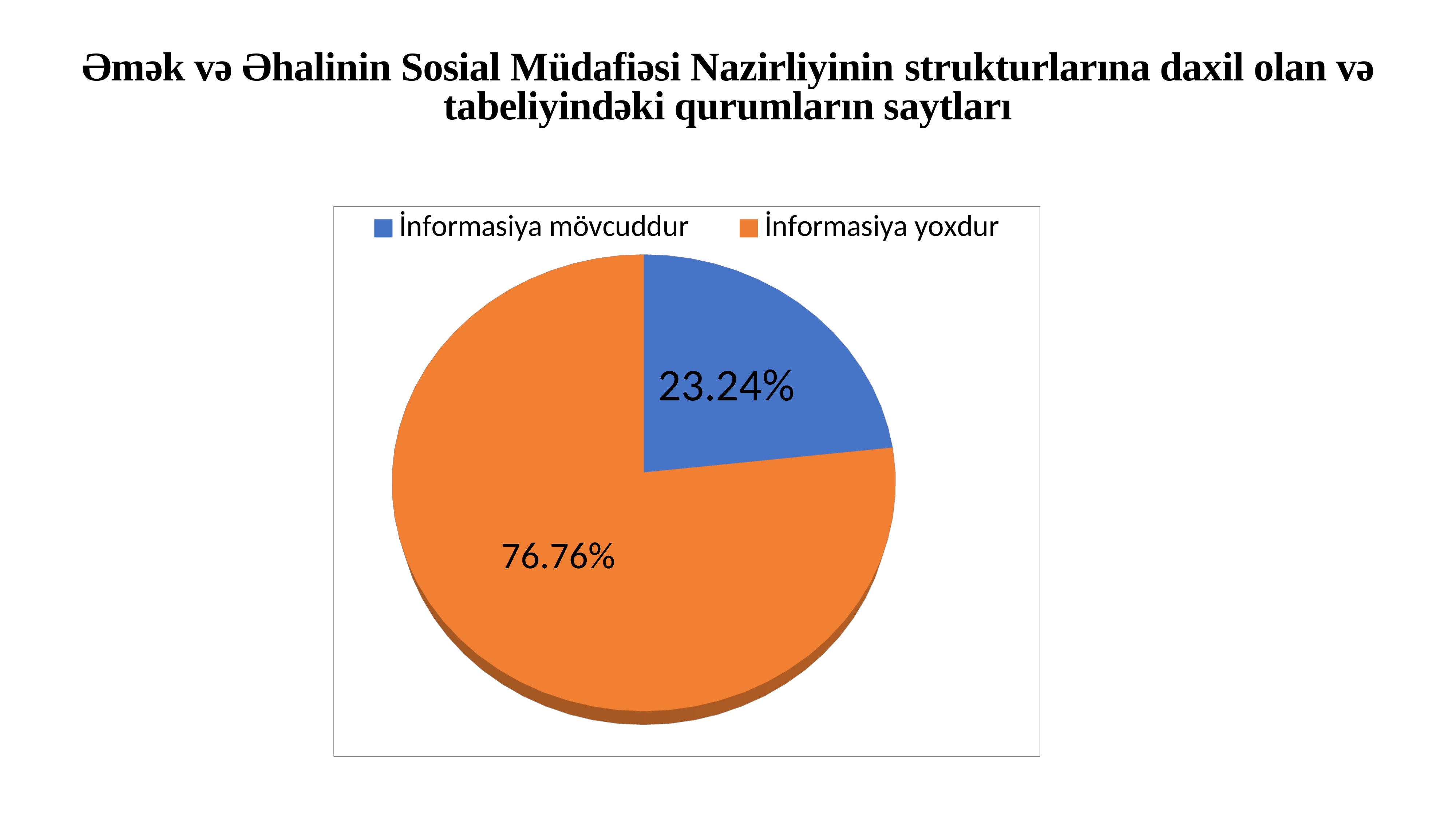
What kind of chart is shown on the slide? pie chart Which slice of the pie is the largest? İnformasiya yoxdur What share of the pie does "İnformasiya yoxdur" represent? 76.76% Which is larger: the "İnformasiya mövcuddur" slice or the "İnformasiya yoxdur" slice? İnformasiya yoxdur Which slice of the pie is the smallest? İnformasiya mövcuddur What is the difference in percentage points between the "İnformasiya yoxdur" and "İnformasiya mövcuddur" slices? 53.52 How many slices does the pie chart have? 2 What colour is the "İnformasiya mövcuddur" slice? blue What colour is the "İnformasiya yoxdur" slice? orange What share of the pie does "İnformasiya mövcuddur" represent? 23.24% How many entries does the legend list? 2